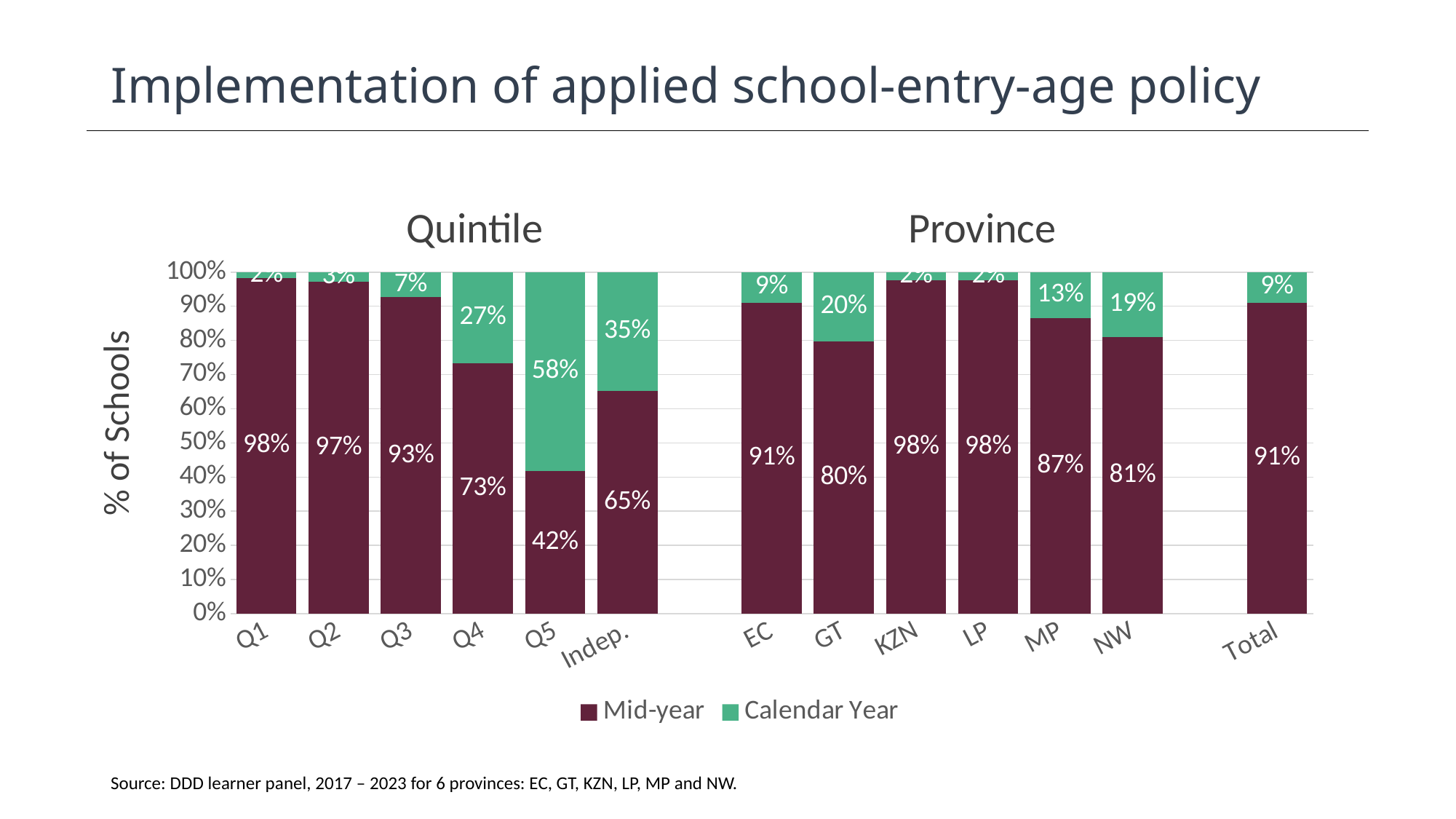
How many series does the legend list? 2 Which has a larger Mid-year value, MP or NW? MP What kind of chart is shown on the slide? Stacked bar chart Which category has the lowest Mid-year value? Q5 Which category has the highest Calendar Year value? Q5 What is the Mid-year value for Q5? 42% What is the Calendar Year value for GT? 20% How many categories are shown on the x axis? 13 What is the Calendar Year value for Indep.? 35% What is the Mid-year value for the Total bar? 91% What is the label on the vertical axis? % of Schools What is the difference between the Mid-year values for Q4 and Q5? 31%